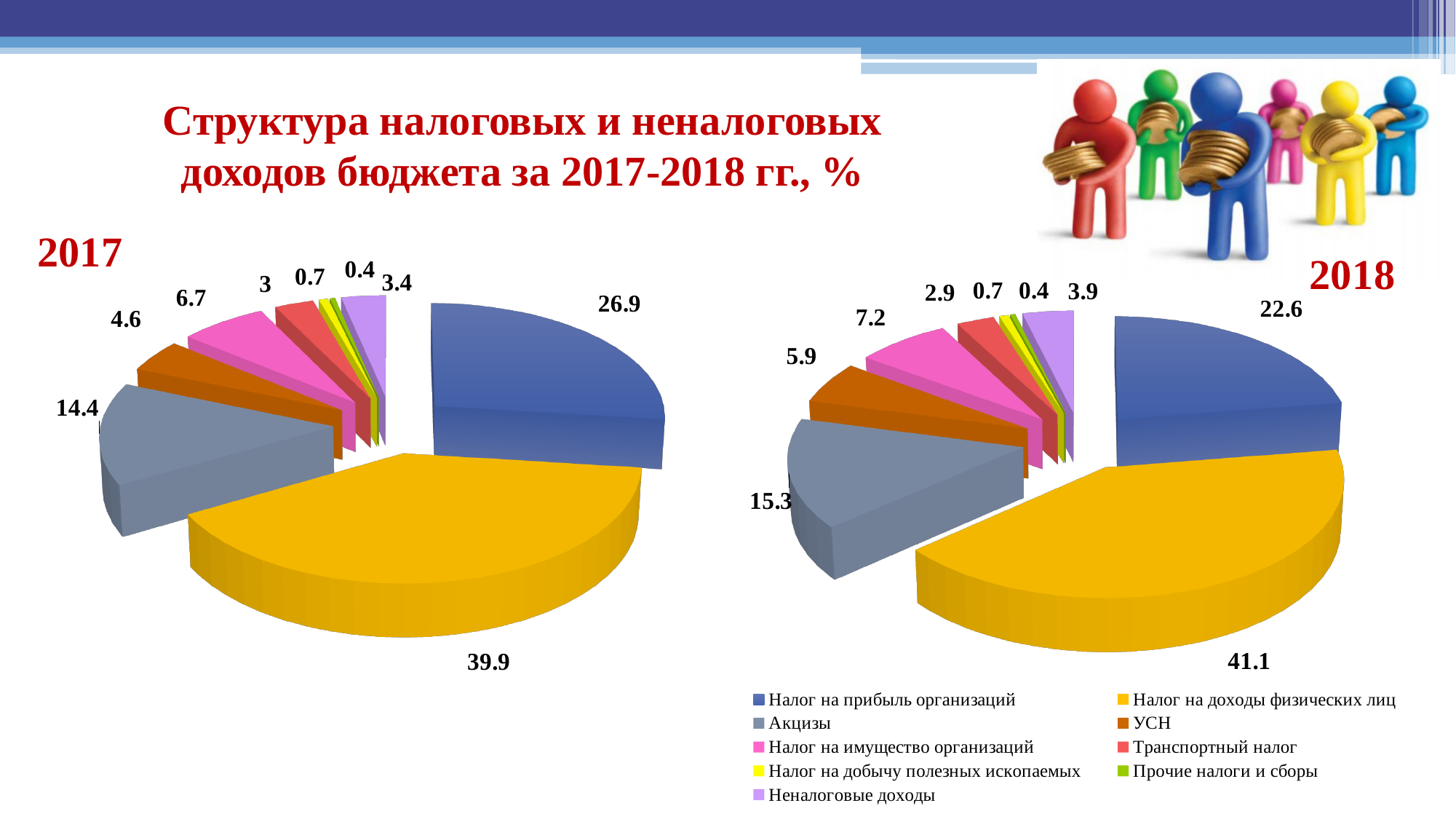
In the 2018 pie chart, what is the value for Акцизы? 15.3 In the 2018 pie chart, which is larger: УСН or Налог на имущество организаций? Налог на имущество организаций What is the difference between the value for Налог на доходы физических лиц in 2018 and in 2017? 1.2 In the 2017 pie chart, what is the value for Неналоговые доходы? 3.4 In the 2017 pie chart, which category has the largest share? Налог на доходы физических лиц How many categories does each pie chart show? 9 In the 2018 pie chart, what is the value for Налог на прибыль организаций? 22.6 In the 2017 pie chart, what is the value for Налог на доходы физических лиц? 39.9 What type of chart is used on this slide? Pie chart What is the title of the slide? Структура налоговых и неналоговых доходов бюджета за 2017-2018 гг., % In the 2018 pie chart, which category has the smallest share? Прочие налоги и сборы In the 2017 pie chart, what is the difference between Налог на прибыль организаций and Акцизы? 12.5